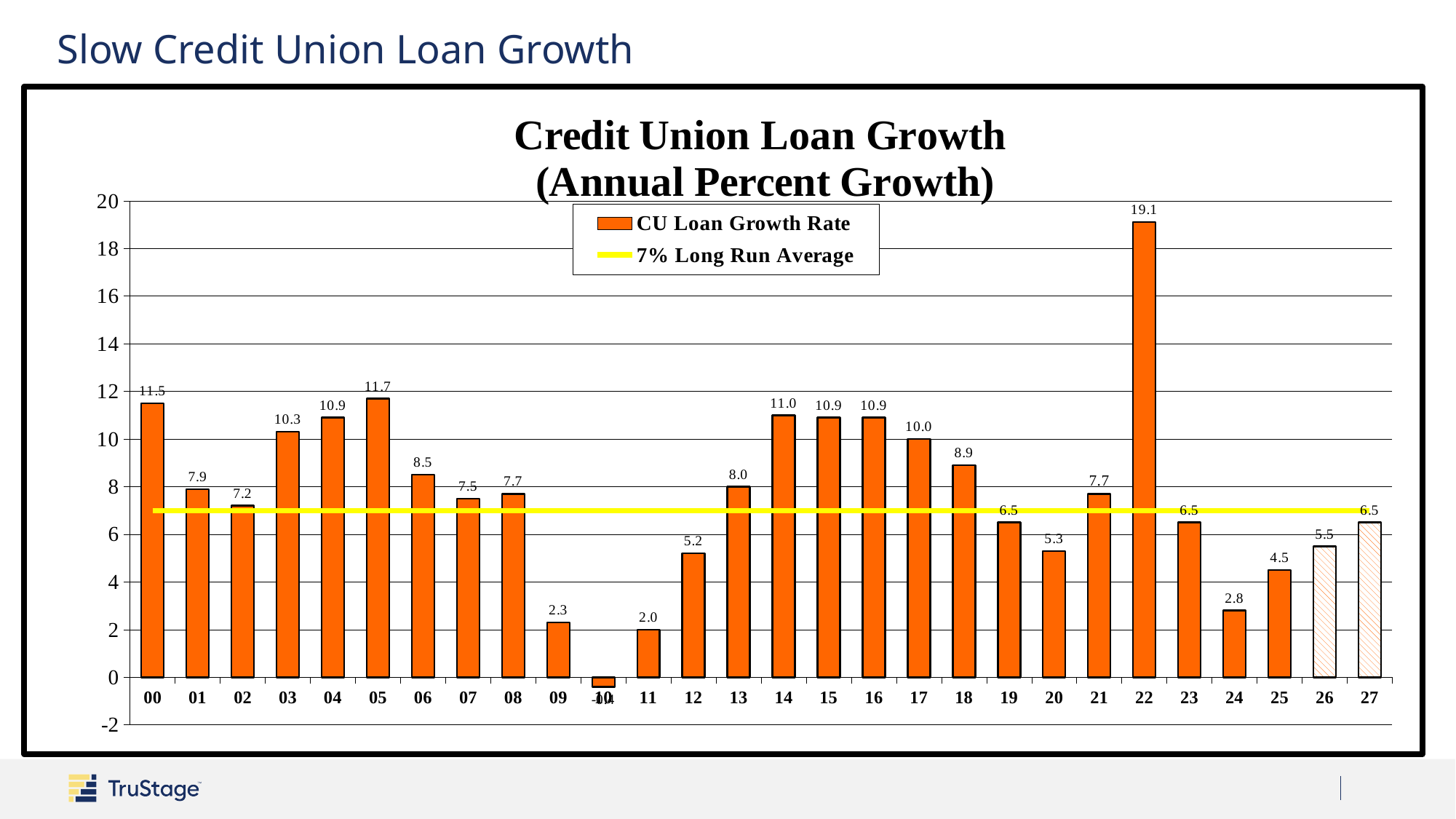
What is the CU Loan Growth Rate for 05? 11.7 Which year has the lowest CU Loan Growth Rate? 10 How many entries does the legend list? 2 Is the CU Loan Growth Rate for 09 greater or less than 4? less Which year has the highest CU Loan Growth Rate? 22 What kind of chart is shown? bar chart What is the CU Loan Growth Rate for 26? 5.5 How many years are shown on the x axis? 28 What is the CU Loan Growth Rate for 24? 2.8 What is the difference between the CU Loan Growth Rate for 22 and for 23? 12.6 Which is larger, the CU Loan Growth Rate for 00 or for 14? 00 What is the CU Loan Growth Rate for 22? 19.1